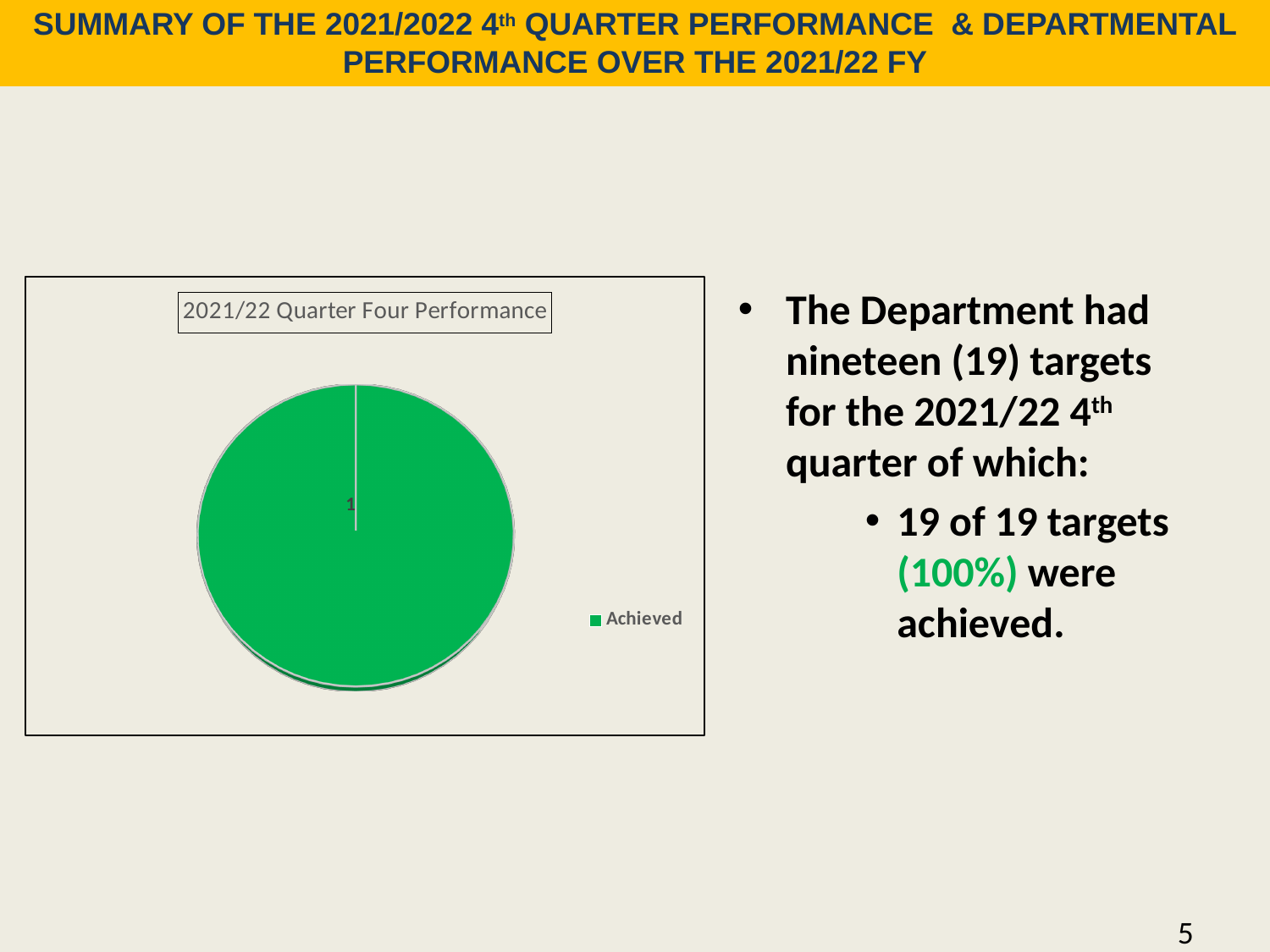
Which category has the largest slice in the pie chart? Achieved What category does the legend entry name? Achieved What kind of chart is shown on the slide? pie chart What is the data label shown on the pie slice? 1 What share of the pie does the Achieved slice take up? 100% How many slices does the pie chart have? 1 How many entries does the chart legend list? 1 What is the title of the chart? 2021/22 Quarter Four Performance